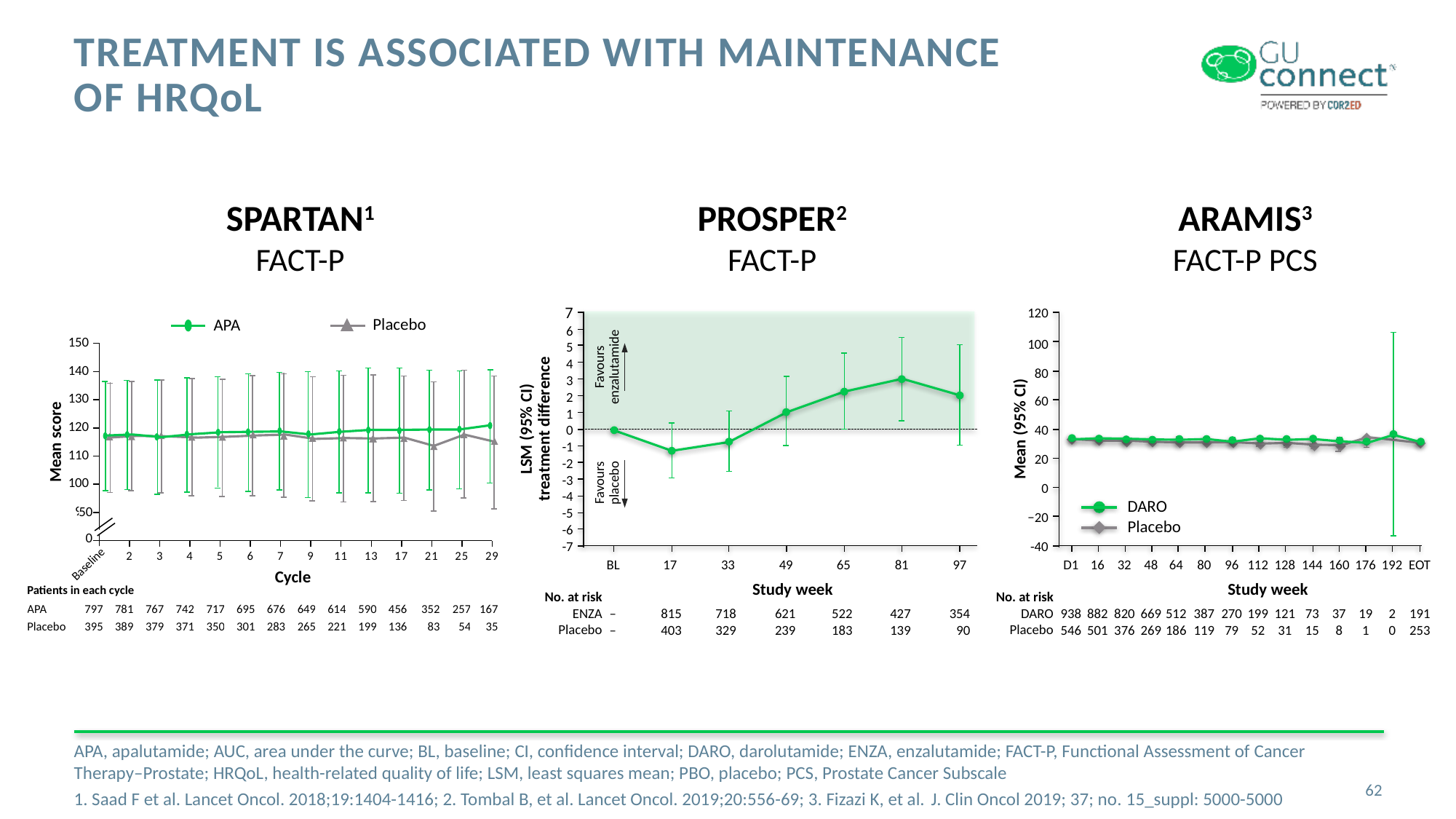
In the PROSPER FACT-P chart, how many ENZA patients are at risk at study week 97? 354 In the SPARTAN FACT-P chart, how many series does the legend list? 2 In the SPARTAN FACT-P chart, what is the difference between the number of APA patients and Placebo patients at Baseline? 402 In the SPARTAN FACT-P chart, how many APA patients are listed at cycle 29? 167 In the PROSPER FACT-P chart, does the LSM treatment difference rise or fall between study week 17 and study week 81? rise In the SPARTAN FACT-P chart, is the APA mean score at cycle 29 greater or less than 110? greater In the PROSPER FACT-P chart, how many study week points are plotted on the x axis? 7 In the PROSPER FACT-P chart, is the LSM treatment difference at study week 17 greater or less than 0? less In the ARAMIS FACT-P PCS chart, how many DARO patients are at risk at D1? 938 In the SPARTAN FACT-P chart, how many Placebo patients are listed at Baseline? 395 In the ARAMIS FACT-P PCS chart, what is the x-axis label? Study week What kind of chart is the SPARTAN FACT-P chart? Line chart